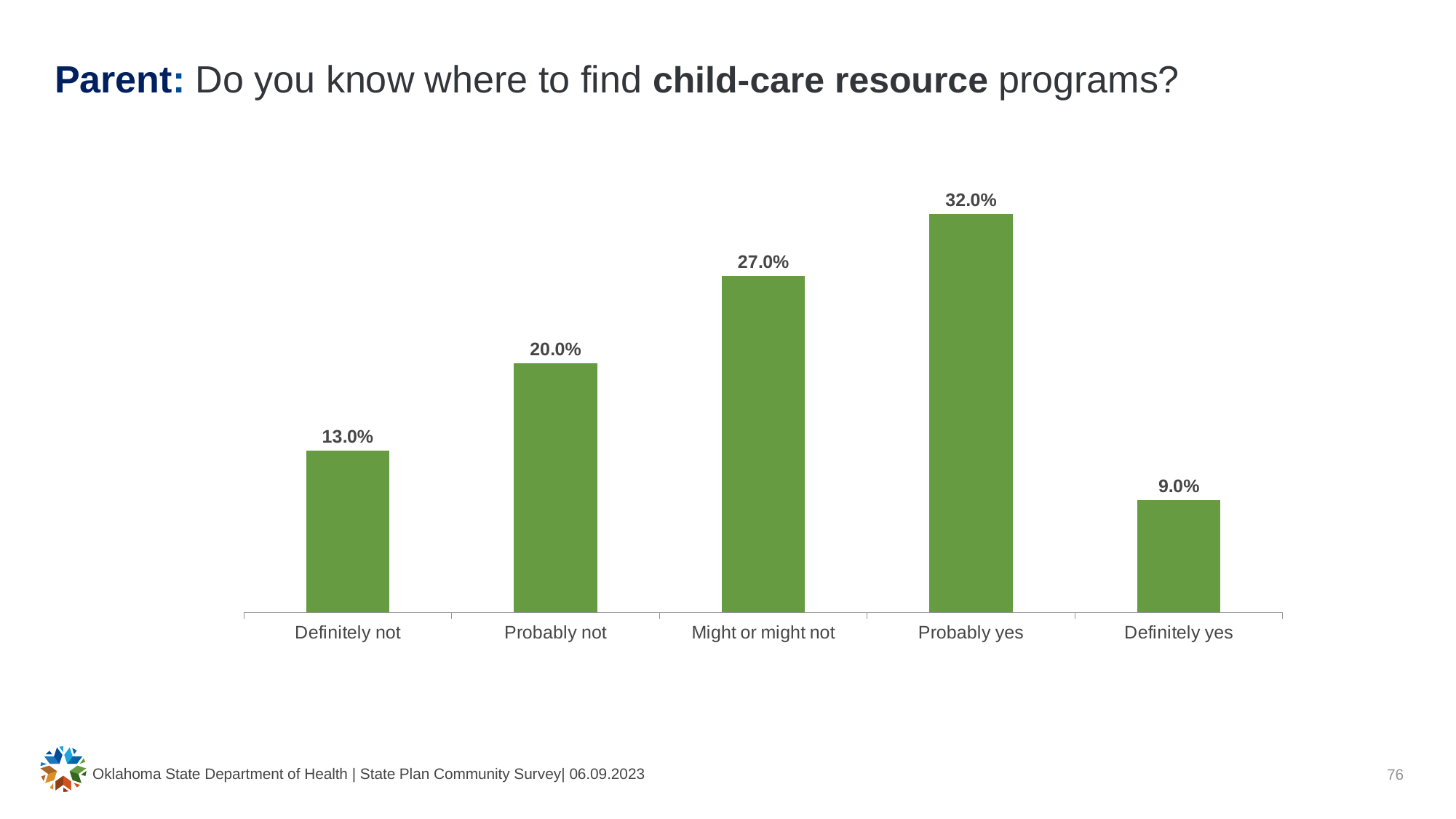
How many response categories are shown on the x axis? 5 Which is larger, the value for "Probably not" or the value for "Definitely yes"? Probably not What percentage of parents answered "Probably yes"? 32.0% What colour are the bars in the chart? Green Which response category has the lowest value? Definitely yes What is the value shown for "Definitely not"? 13.0% What is the value for "Definitely yes"? 9.0% What kind of chart is shown on the slide? Bar chart What percentage is shown for "Might or might not"? 27.0% What is the difference between "Might or might not" and "Definitely not"? 14.0% Which response category has the highest value? Probably yes What is the difference between the values for "Probably yes" and "Probably not"? 12.0%